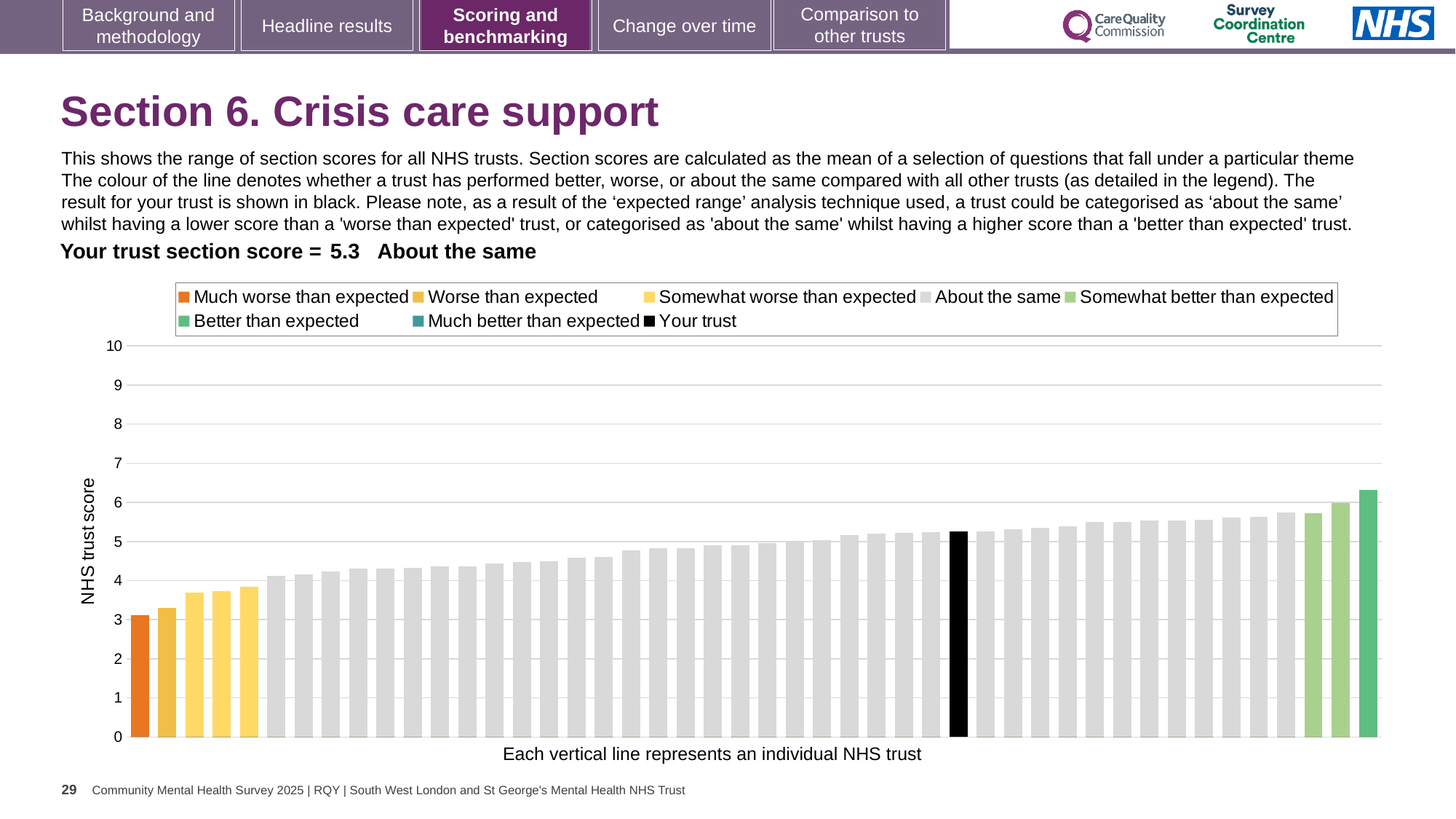
Is the value of the tallest bar greater or less than 7? less Do the bar values rise or fall from left to right along the x axis? Rise What is the section score for your trust shown on the slide? 5.3 Is the value of the tallest bar greater or less than 6? greater What is the label on the vertical axis of the chart? NHS trust score Which category is your trust placed in for this section? About the same Which legend category does the lowest bar on the chart belong to? Much worse than expected Which legend category does the highest bar on the chart belong to? Better than expected What kind of chart is shown on the slide? Bar chart Is the value of the black bar (your trust) greater or less than 5? greater How many entries does the chart legend list? 8